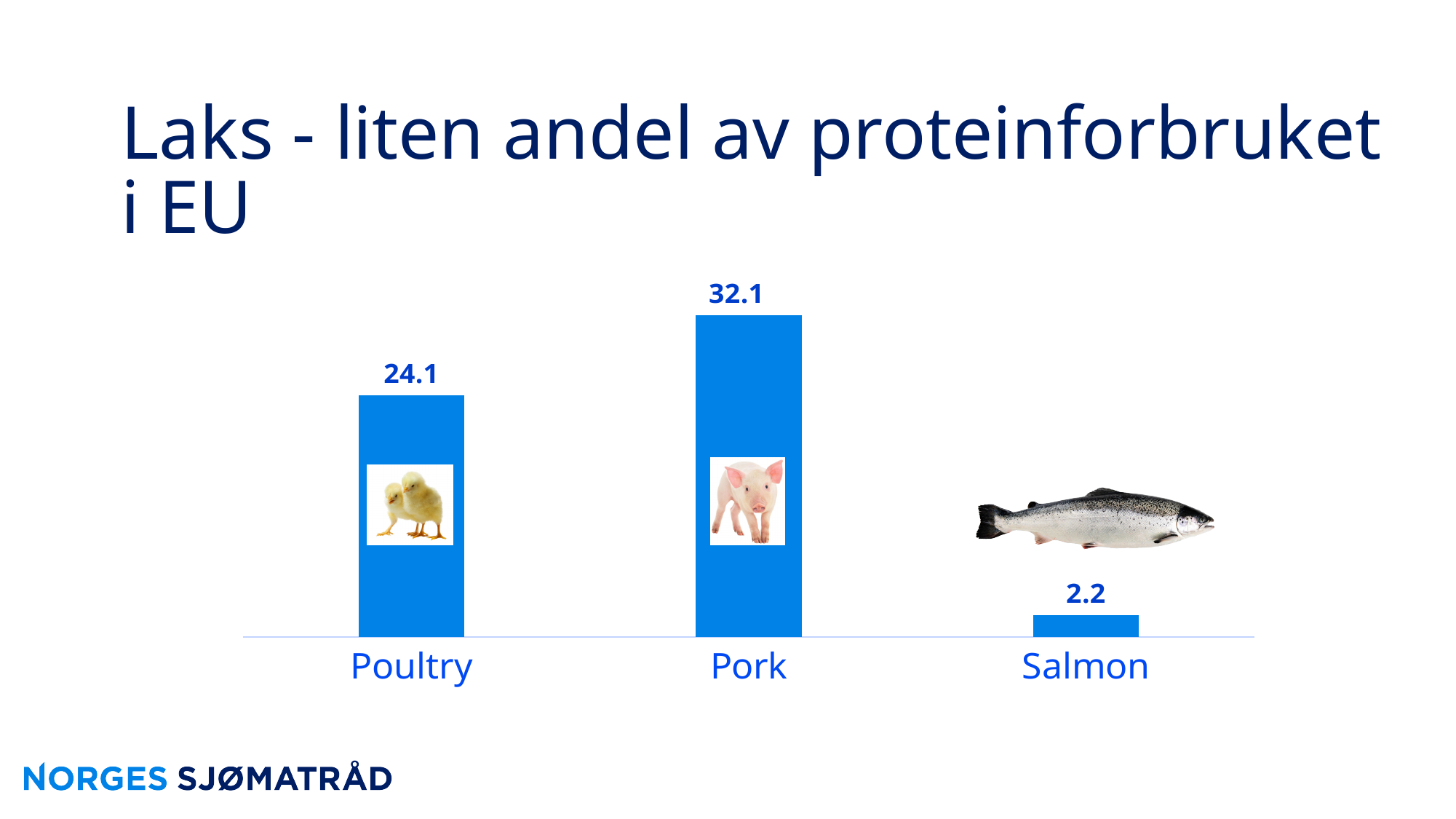
How many categories are shown in the chart? 3 What colour are the bars in the chart? Blue What kind of chart is shown on the slide? Bar chart What is the value for Salmon? 2.2 What is the value for Pork? 32.1 Which is larger, the value for Poultry or the value for Salmon? Poultry What is the difference between the values for Pork and Poultry? 8.0 What is the value for Poultry? 24.1 Which category has the lowest value? Salmon What is the difference between the values for Poultry and Salmon? 21.9 What is the title of the slide? Laks - liten andel av proteinforbruket i EU Which category has the highest value? Pork